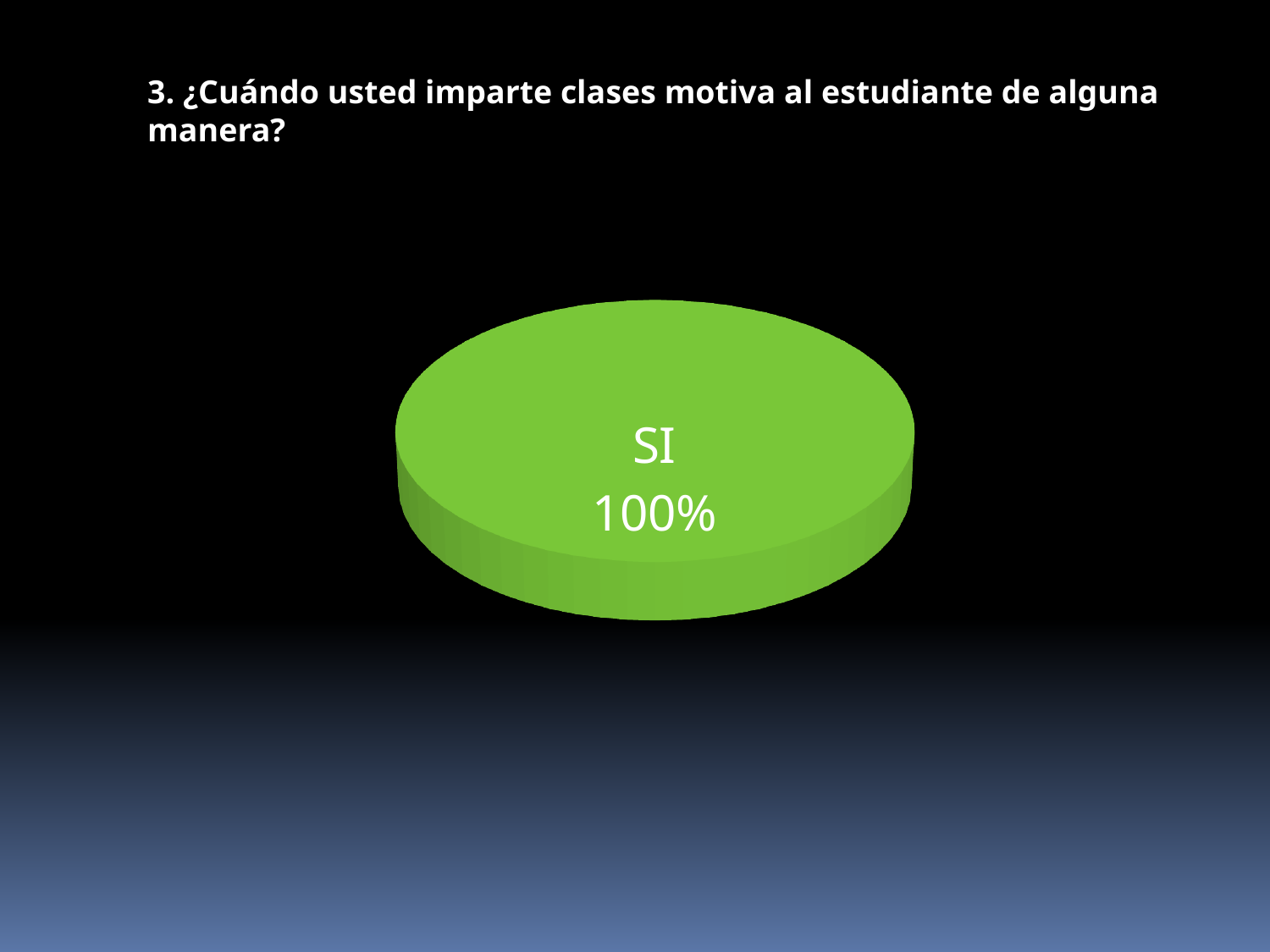
What kind of chart is shown on the slide? pie chart What is the label of the only slice in the pie chart? SI What share of the pie does the SI slice represent? 100% What percentage is shown for the SI slice? 100% What colour is the SI slice? green Which category makes up the entire pie? SI How many slices does the pie chart have? 1